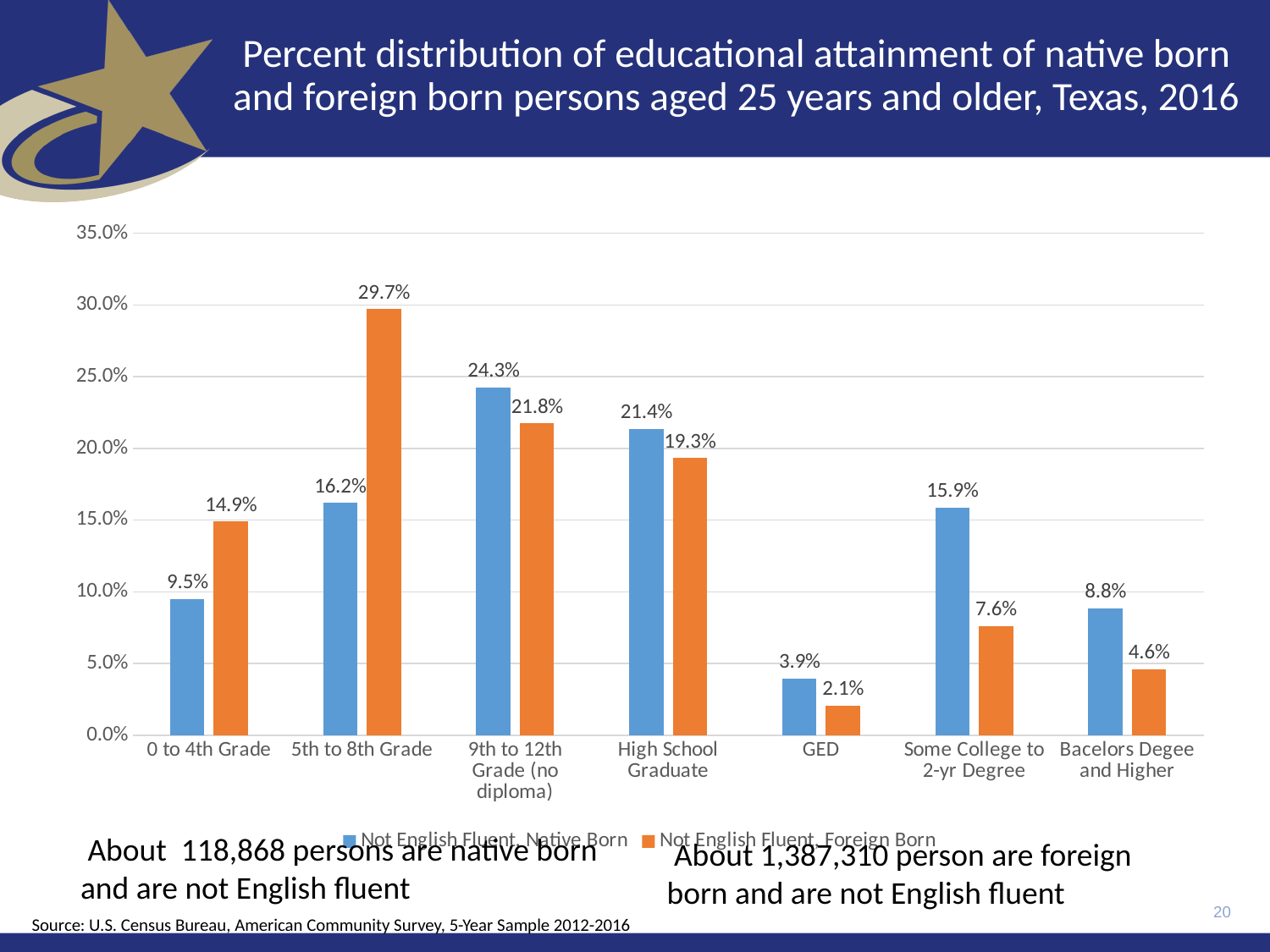
What kind of chart is shown on the slide? bar chart How many educational attainment categories are shown on the x axis? 7 What is the value for Not English Fluent, Foreign Born in the High School Graduate category? 19.3% What is the value for Not English Fluent, Native Born in the 5th to 8th Grade category? 16.2% Which category has the lowest value for Not English Fluent, Native Born? GED Which category has the highest value for Not English Fluent, Foreign Born? 5th to 8th Grade In the Some College to 2-yr Degree category, which series has the larger value? Not English Fluent, Native Born What is the difference between the Foreign Born and Native Born values in the 0 to 4th Grade category? 5.4% Which colour represents Not English Fluent, Foreign Born in the chart? orange What is the value for Not English Fluent, Native Born in the GED category? 3.9% Is the value for Not English Fluent, Native Born in the 9th to 12th Grade (no diploma) category greater or less than 20.0%? greater How many series does the legend list? 2